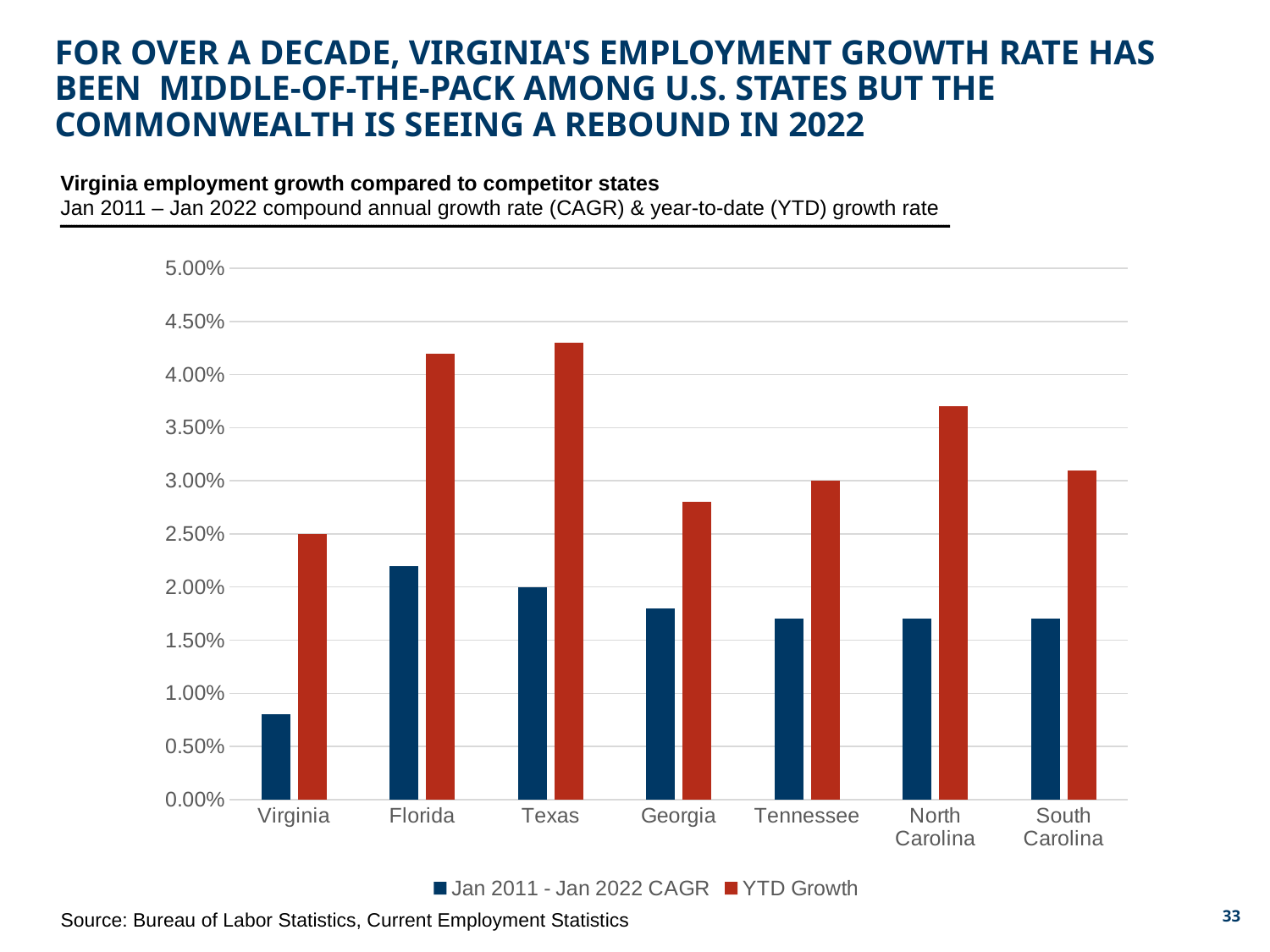
What is the YTD Growth value for Virginia? 2.50% What is the Jan 2011 - Jan 2022 CAGR value for Texas? 2.00% Is the Jan 2011 - Jan 2022 CAGR value for Virginia greater or less than 1.00%? less What kind of chart is shown on the slide? Bar chart How many states are shown on the x axis of the chart? 7 How many series does the chart's legend list? 2 Is the YTD Growth value for Florida greater or less than 4.00%? greater Which colour represents the YTD Growth series in the chart? Red Which state has the lowest Jan 2011 - Jan 2022 CAGR? Virginia Which state has the lowest YTD Growth? Virginia Which state has the highest Jan 2011 - Jan 2022 CAGR? Florida Which is larger: the YTD Growth for Georgia or the YTD Growth for Tennessee? Tennessee